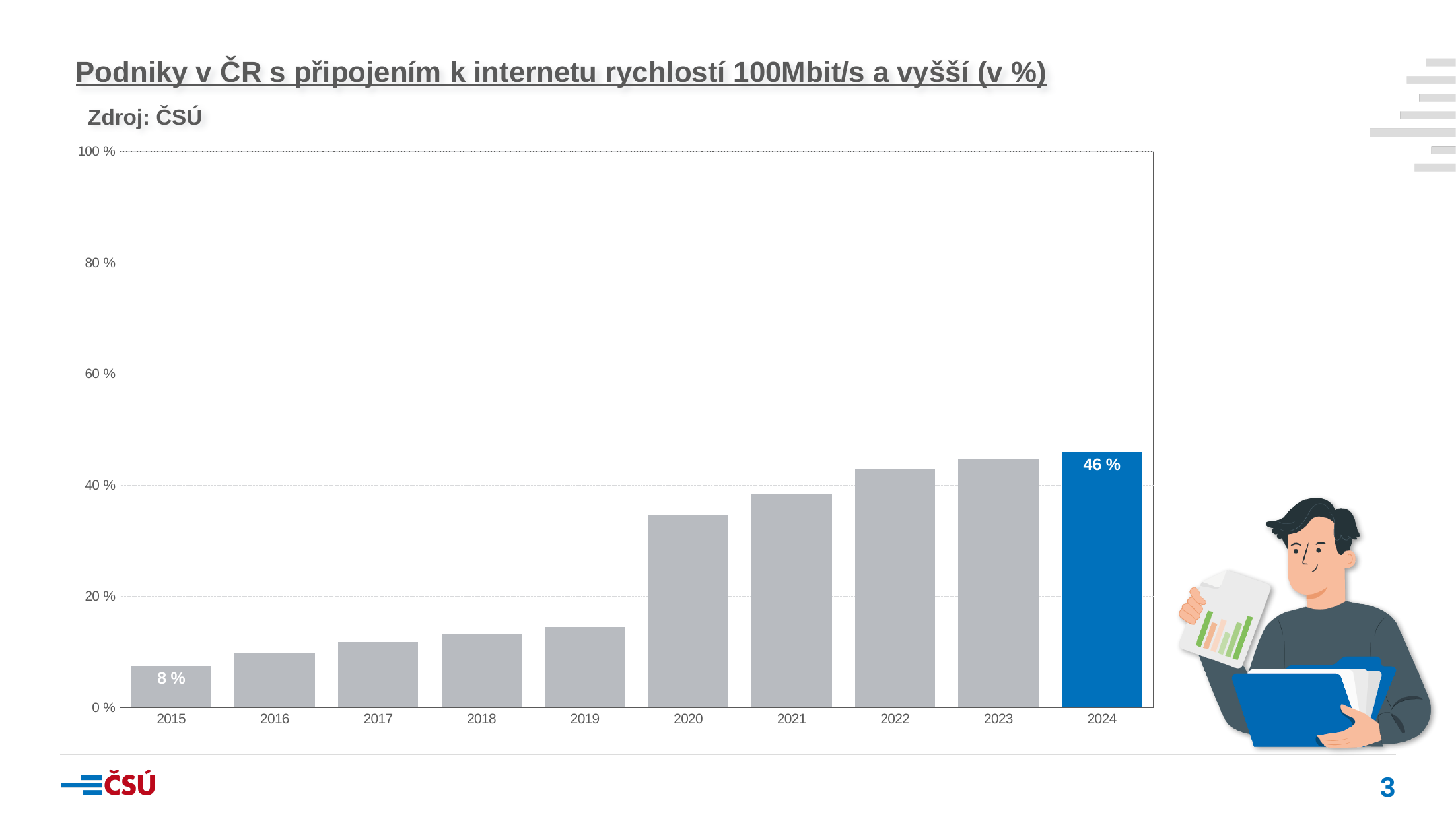
What is the value for 2015? 8 % What is the value for 2024? 46 % How many years are shown on the x axis? 10 What is the difference between the values for 2024 and 2015? 38 % Is the value for 2023 greater or less than 60 %? less Do the values rise or fall from 2015 to 2024? rise Which year has the lowest value? 2015 Is the value for 2020 greater or less than 20 %? greater What kind of chart is shown on the slide? bar chart Which year has the highest value? 2024 Is the value for 2018 greater or less than 20 %? less Which is larger, the value for 2020 or the value for 2019? 2020